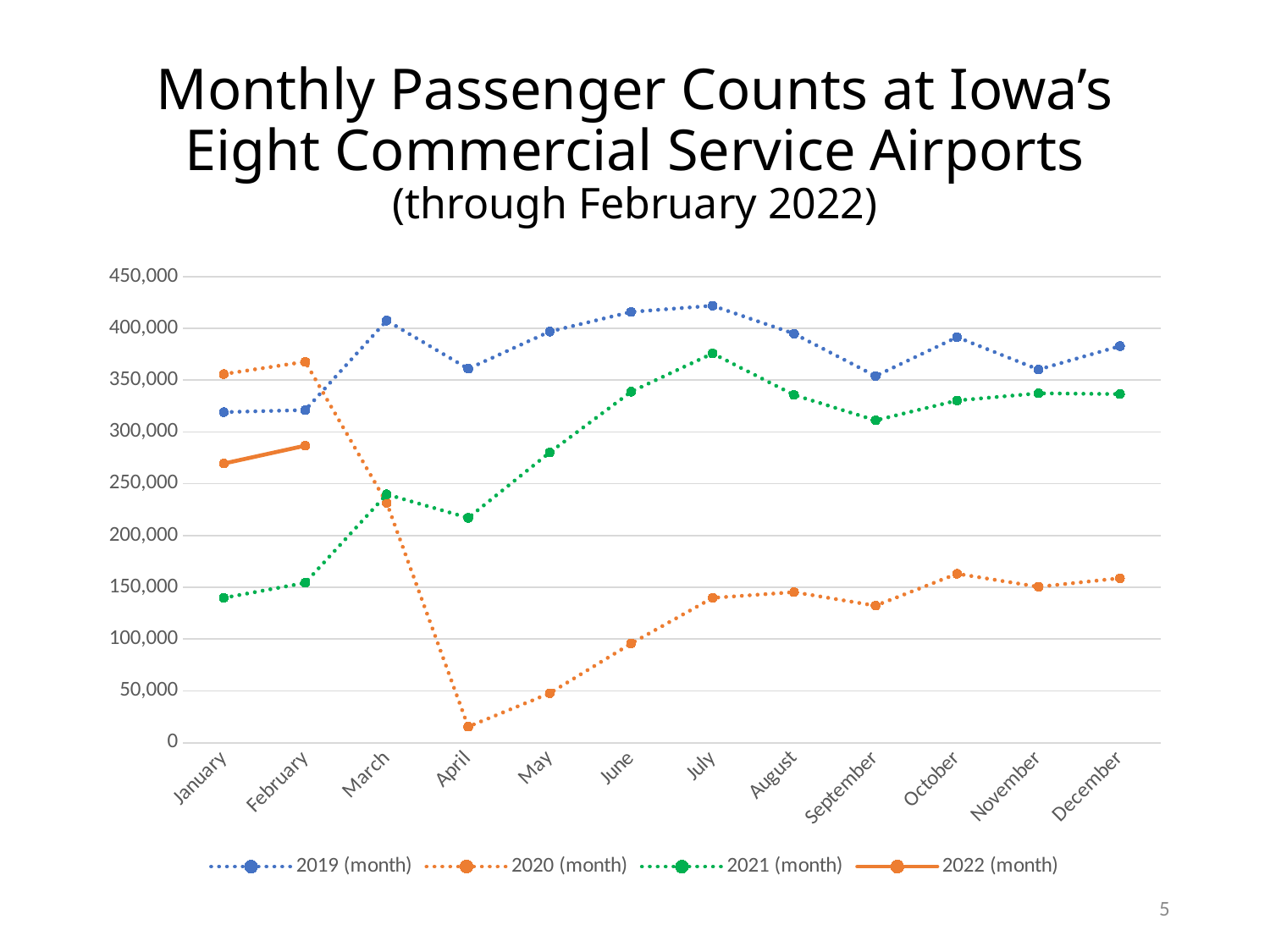
Is the 2020 (month) value for April greater or less than 50,000? less In December, which series has the larger value: 2019 (month) or 2021 (month)? 2019 (month) Does the 2020 (month) series rise or fall from March to April? fall What kind of chart is shown on the slide? line chart Is the 2021 (month) value for January greater or less than 150,000? less Is the 2022 (month) value for February greater or less than 300,000? less How many months are shown along the x axis? 12 In which month is the 2021 (month) value highest? July In which month is the 2020 (month) value lowest? April In January, which series has the larger value: 2020 (month) or 2022 (month)? 2020 (month) How many series does the legend list? 4 Which series is drawn with a solid line rather than a dotted line? 2022 (month)